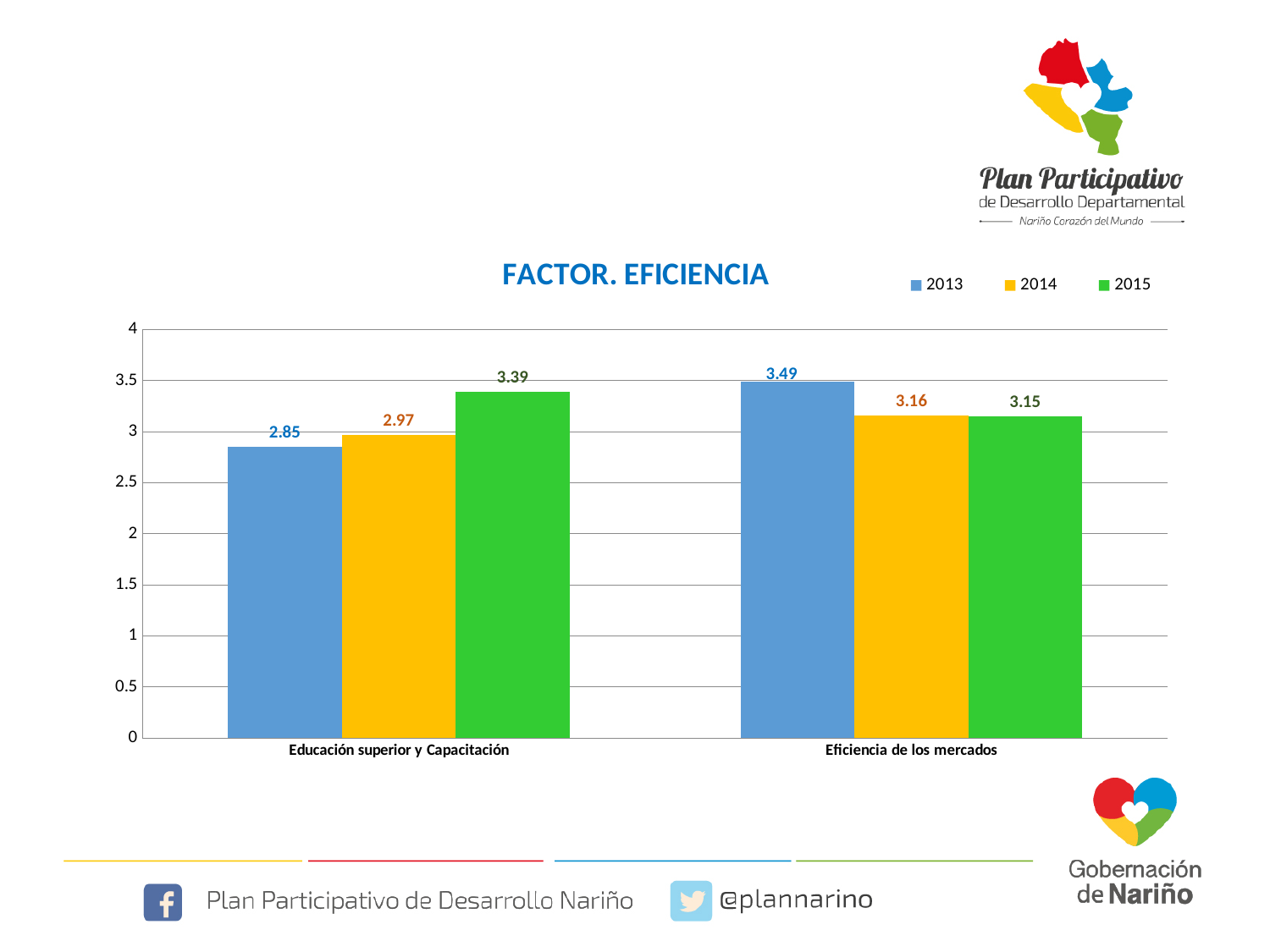
What is the title of the chart? FACTOR. EFICIENCIA How many series does the legend list? 3 What is the difference between the 2015 and 2013 values for Educación superior y Capacitación? 0.54 What is the value for 2013 in the Educación superior y Capacitación category? 2.85 How many categories are shown on the x axis? 2 Which is larger: the 2013 value for Eficiencia de los mercados or the 2015 value for Educación superior y Capacitación? 2013 value for Eficiencia de los mercados Which year has the highest value in the Eficiencia de los mercados category? 2013 Do the values for Educación superior y Capacitación rise or fall from 2013 to 2015? Rise What kind of chart is shown on the slide? Bar chart Which year has the lowest value in the Educación superior y Capacitación category? 2013 What is the value for 2014 in the Educación superior y Capacitación category? 2.97 What is the value for 2015 in the Eficiencia de los mercados category? 3.15